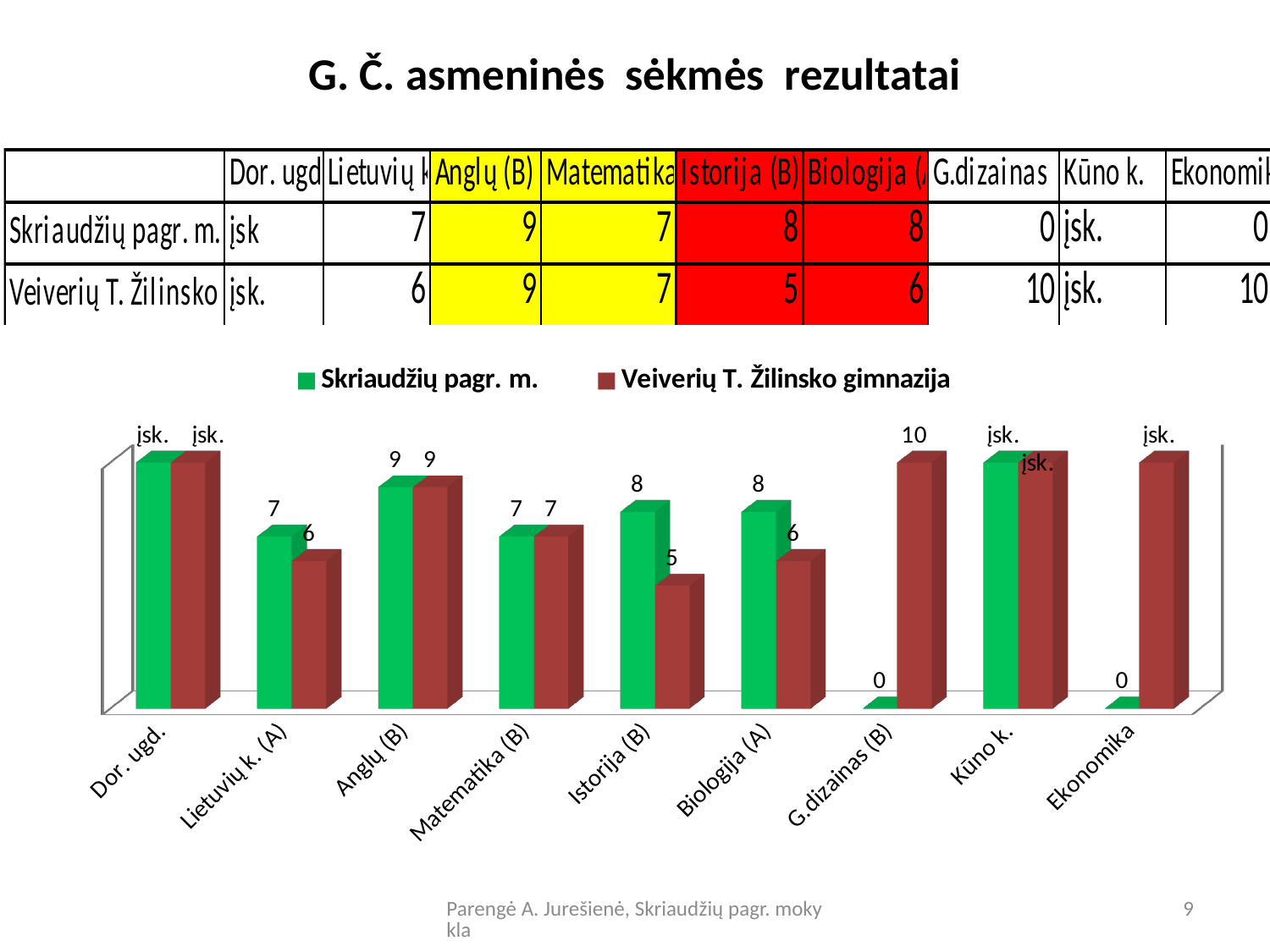
Which series has the larger value for G.dizainas (B)? Veiverių T. Žilinsko gimnazija What is the value for Skriaudžių pagr. m. in Ekonomika on the chart? 0 What is the value for Veiverių T. Žilinsko gimnazija in G.dizainas (B) on the chart? 10 What is the value for Veiverių T. Žilinsko gimnazija in Istorija (B) on the chart? 5 What is the difference between the Skriaudžių pagr. m. and Veiverių T. Žilinsko gimnazija values for Istorija (B)? 3 How many subject categories are shown along the x axis of the chart? 9 What kind of chart is shown on the slide? bar chart What is the value for Skriaudžių pagr. m. in Anglų (B) on the chart? 9 How many series does the chart legend list? 2 Which series has the larger value for Biologija (A)? Skriaudžių pagr. m. Among the numeric values, which category has the lowest value for Veiverių T. Žilinsko gimnazija? Istorija (B) Which colour represents Skriaudžių pagr. m. in the chart? green